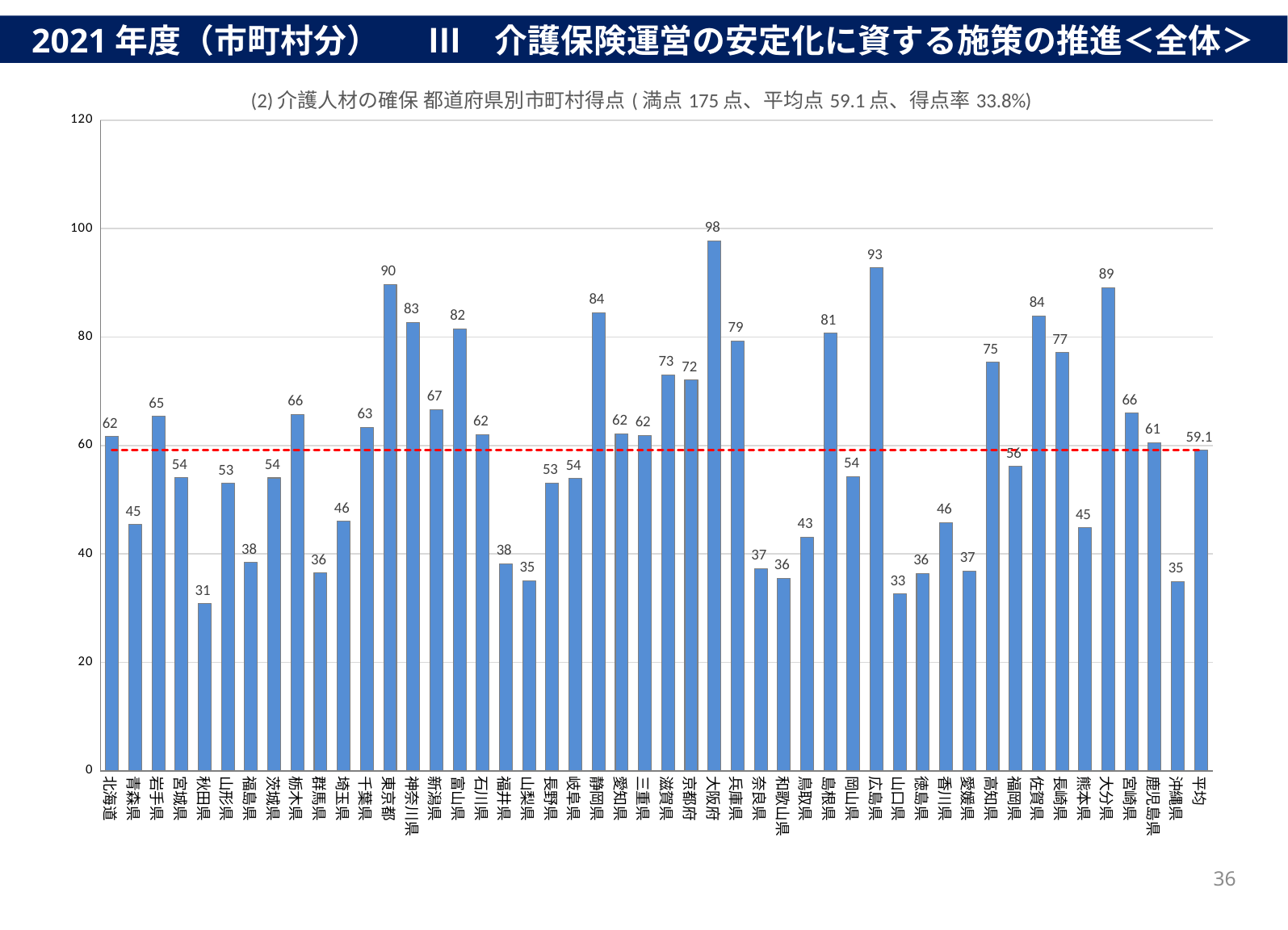
What is the value for 大阪府? 98 Which category has the lowest value? 秋田県 How many bars are plotted in the chart? 48 Which category has the highest value? 大阪府 What is the difference between the values for 広島県 and 山口県? 60 What is the value for 東京都? 90 Is the value for 佐賀県 greater or less than 80? greater Is the value for 沖縄県 greater or less than 40? less Which is larger, the value for 神奈川県 or the value for 富山県? 神奈川県 What kind of chart is shown on the slide? bar chart What is the value shown for 平均? 59.1 What value does the red dashed horizontal line mark? 59.1